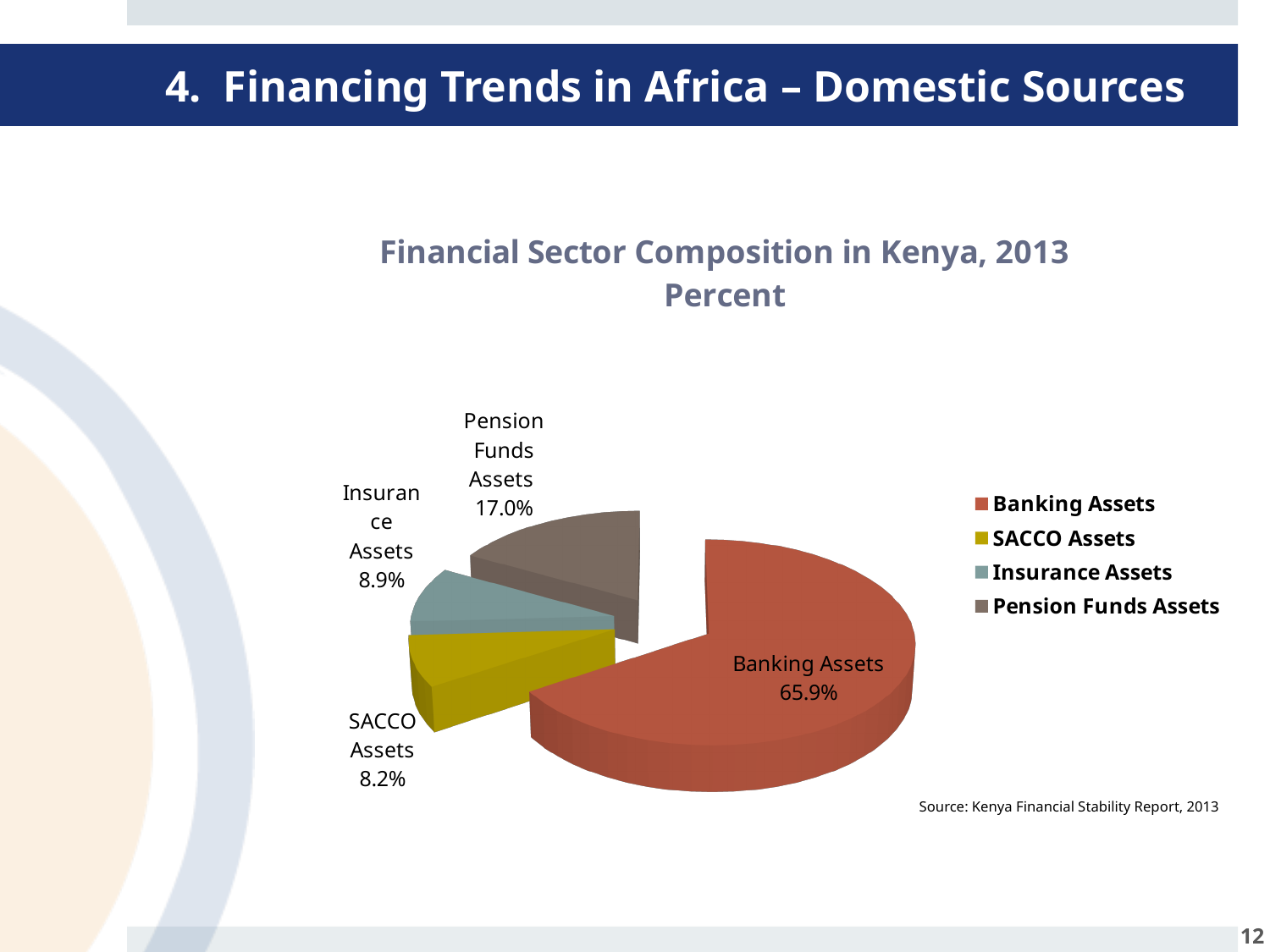
What is the difference between the Insurance Assets share and the SACCO Assets share? 0.7% Which is larger, Pension Funds Assets or Insurance Assets? Pension Funds Assets What is the title of the chart? Financial Sector Composition in Kenya, 2013 Percent What is the value shown for Pension Funds Assets? 17.0% What is the value shown for SACCO Assets? 8.2% What share of the pie does Banking Assets hold? 65.9% What is the difference between the Banking Assets share and the Pension Funds Assets share? 48.9% Which category has the largest slice of the pie? Banking Assets What kind of chart is shown on the slide? Pie chart How many categories are shown in the pie chart? 4 Which category has the smallest slice of the pie? SACCO Assets What is the value shown for Insurance Assets? 8.9%